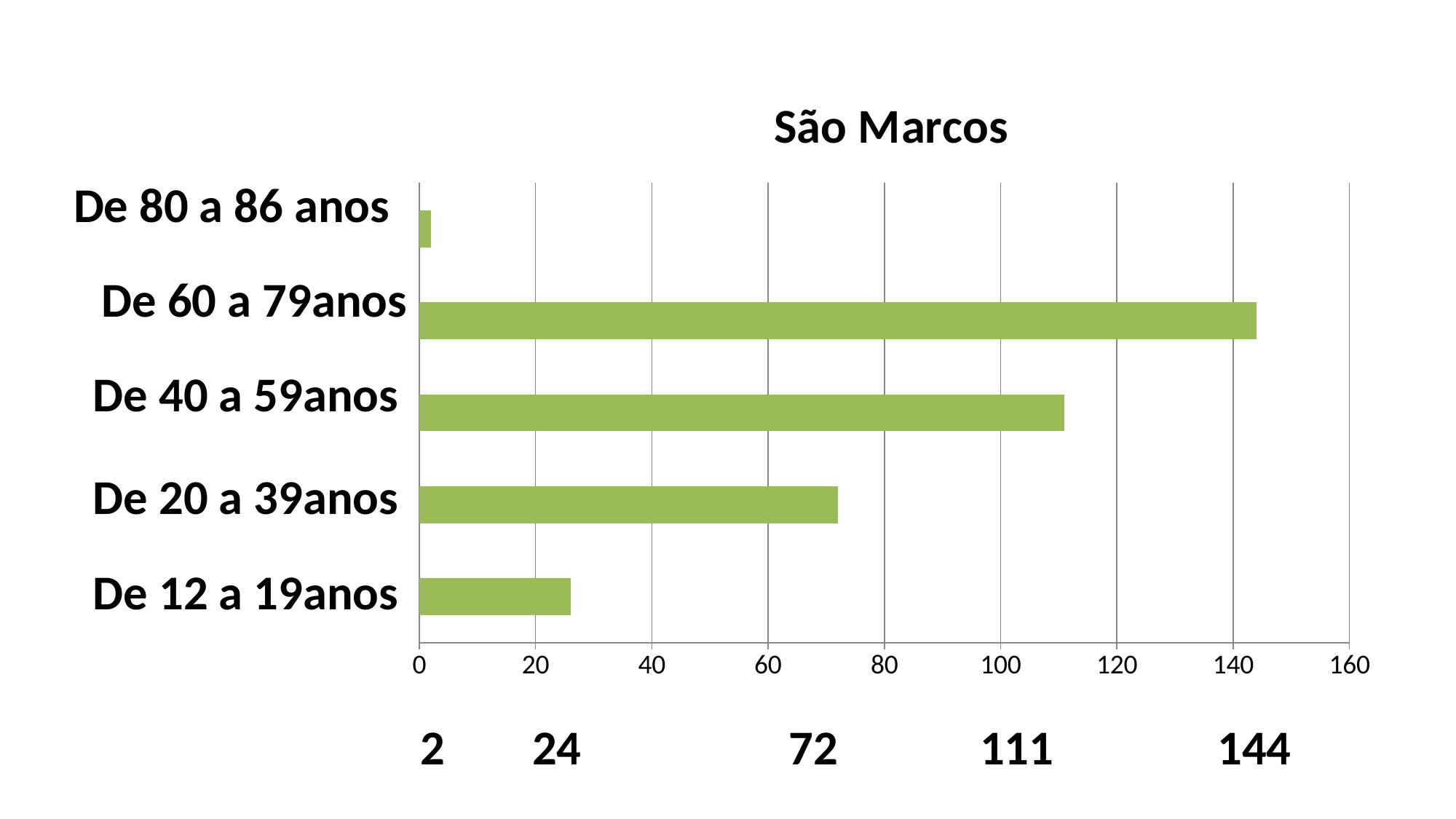
What is the value for De 40 a 59anos? 111 Which has a larger value, De 40 a 59anos or De 20 a 39anos? De 40 a 59anos What is the value for De 80 a 86 anos? 2 What is the title of the chart? São Marcos Which age category has the lowest value? De 80 a 86 anos Which age category has the highest value? De 60 a 79anos What kind of chart is shown on the slide? bar chart What is the value for De 60 a 79anos? 144 Is the value for De 20 a 39anos greater or less than 80? less What is the difference between the values for De 60 a 79anos and De 40 a 59anos? 33 How many age categories are plotted in the chart? 5 What is the value for De 20 a 39anos? 72